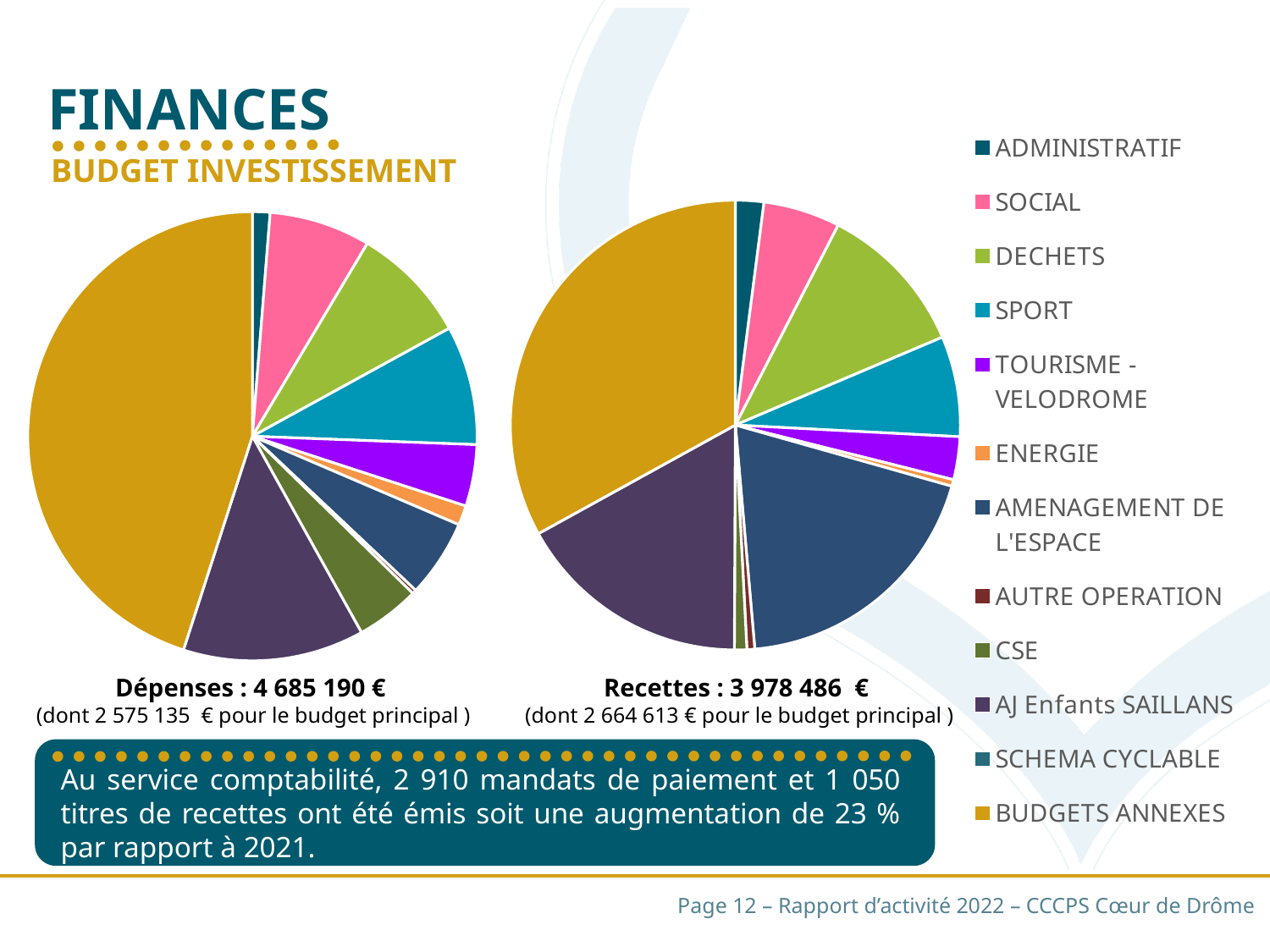
What kind of chart is used for the Dépenses chart on the left? pie chart What total amount is given in the caption of the Recettes pie chart? 3 978 486 € In the Recettes pie chart, which slice is larger: AMENAGEMENT DE L'ESPACE or SOCIAL? AMENAGEMENT DE L'ESPACE What total amount is given in the caption of the Dépenses pie chart? 4 685 190 € In the Dépenses pie chart, which category has the largest slice? BUDGETS ANNEXES In the Recettes pie chart, which slice is larger: DECHETS or ENERGIE? DECHETS In the Dépenses pie chart, which slice is larger: BUDGETS ANNEXES or AMENAGEMENT DE L'ESPACE? BUDGETS ANNEXES How many categories does the shared legend list? 12 In the Recettes pie chart, which category has the largest slice? BUDGETS ANNEXES What kind of chart is used for the Recettes chart on the right? pie chart